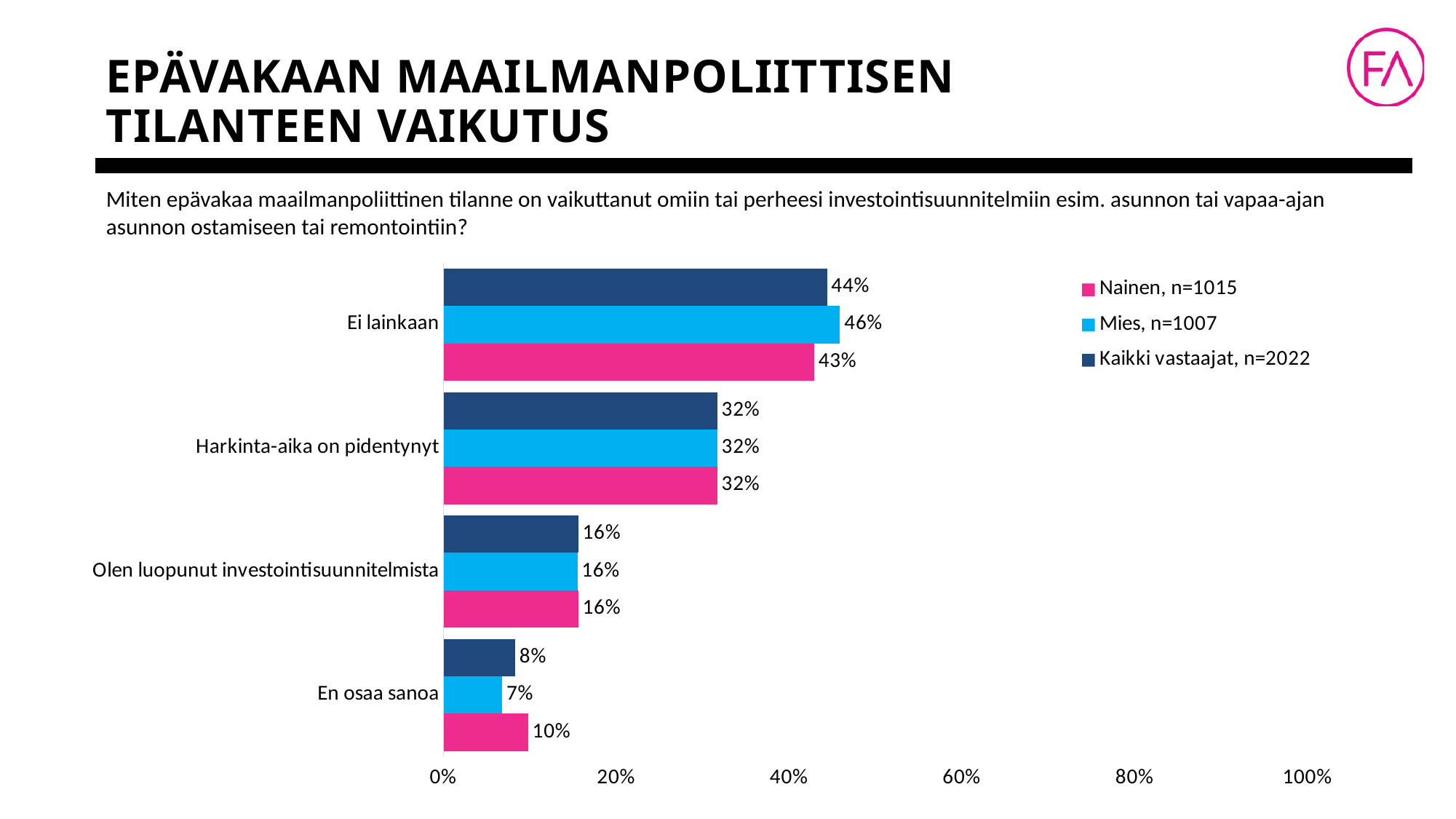
What kind of chart is shown on the slide? Bar chart Is the value for Kaikki vastaajat, n=2022 in the Ei lainkaan category greater or less than 40%? greater How many series does the legend list? 3 Which colour represents the Nainen, n=1015 series? Pink Which category has the highest value for Kaikki vastaajat, n=2022? Ei lainkaan What is the value for Mies, n=1007 in the Ei lainkaan category? 46% How many categories are shown on the chart? 4 What is the difference between the Mies, n=1007 and Nainen, n=1015 values in the Ei lainkaan category? 3% What is the value for Nainen, n=1015 in the En osaa sanoa category? 10% In the En osaa sanoa category, which is larger: the value for Nainen, n=1015 or the value for Mies, n=1007? Nainen, n=1015 What is the value for Kaikki vastaajat, n=2022 in the Harkinta-aika on pidentynyt category? 32% Which category has the lowest value for Mies, n=1007? En osaa sanoa